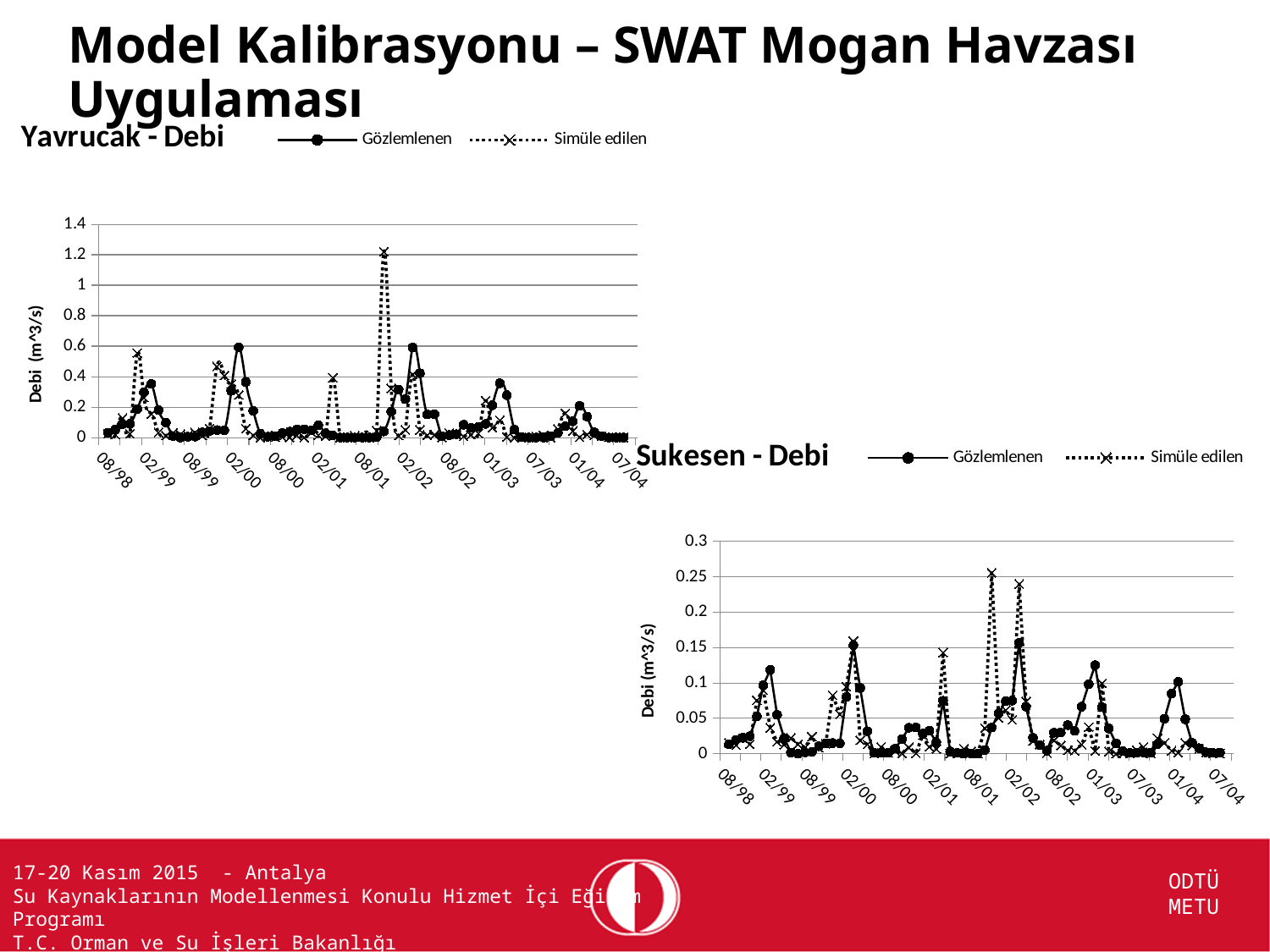
In the "Yavrucak - Debi" chart, which series reaches the highest peak value? Simüle edilen In the "Sukesen - Debi" chart, is the highest value of the Gözlemlenen series greater or less than 0.2? less What kind of chart is the "Yavrucak - Debi" chart? line chart What are the two series named in the legend of the "Yavrucak - Debi" chart? Gözlemlenen and Simüle edilen In the "Yavrucak - Debi" chart, is the highest value of the Simüle edilen series greater or less than 1? greater In the "Yavrucak - Debi" chart, is the highest value of the Gözlemlenen series greater or less than 0.8? less How many series does the legend of the "Sukesen - Debi" chart list? 2 How many date labels are shown on the x axis of the "Yavrucak - Debi" chart? 13 What is the y-axis label on the "Sukesen - Debi" chart? Debi (m^3/s) What is the maximum value shown on the y axis of the "Yavrucak - Debi" chart? 1.4 In the "Sukesen - Debi" chart, which series reaches the higher peak value, Gözlemlenen or Simüle edilen? Simüle edilen